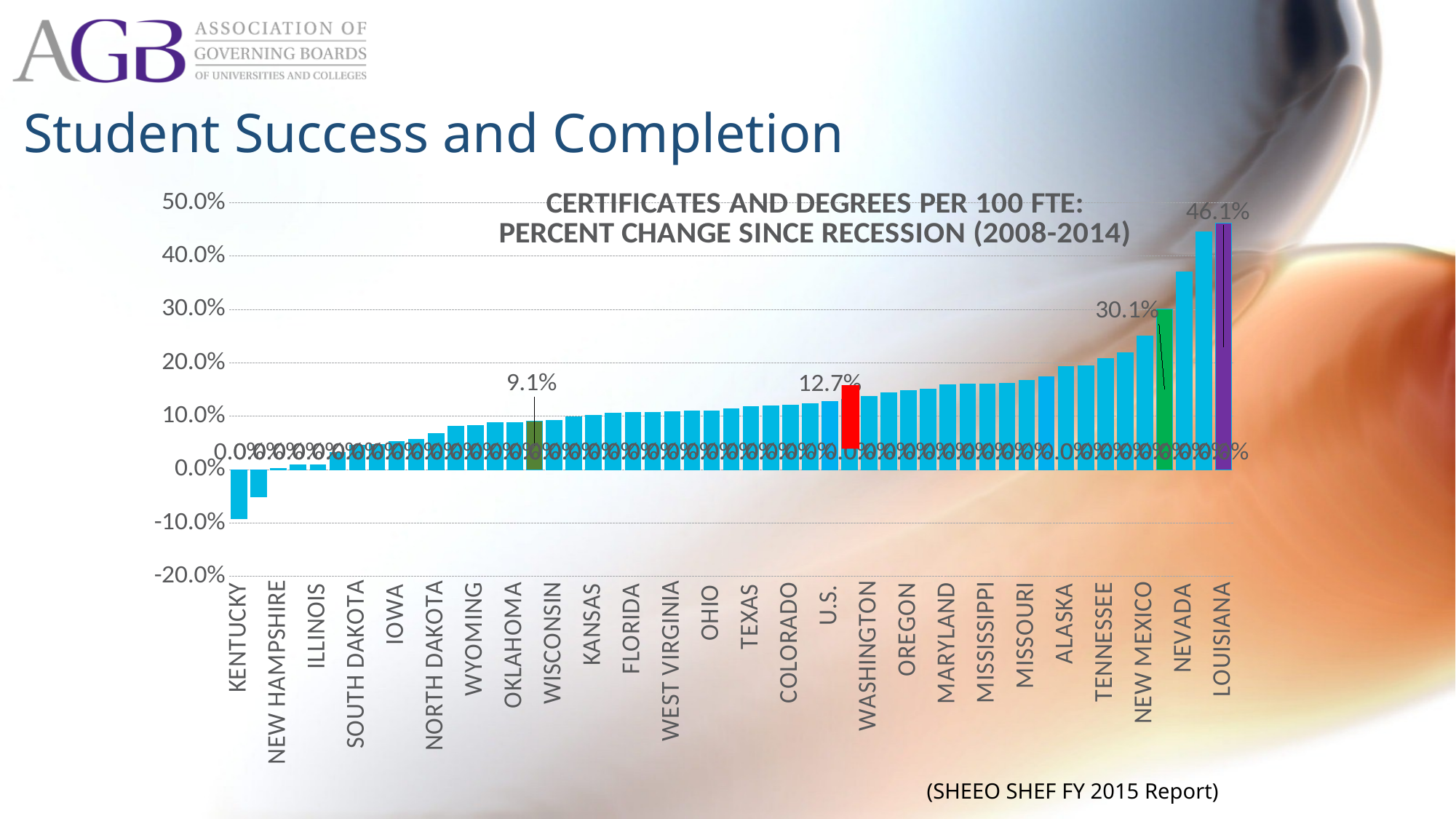
What is the value labeled on the tallest bar (Louisiana)? 46.1% Which is larger, the value for Nevada or the value for Oregon? Nevada Is the value for Kentucky greater or less than -5.0%? less Do the bar values generally rise or fall from left to right along the x axis? rise Which state has the lowest percent change in the chart? Kentucky Is the value for Nevada greater or less than 30.0%? greater Which state has the highest percent change in the chart? Louisiana Is the value for Missouri greater or less than 20.0%? less What type of chart is shown on the slide? bar chart What is the title of the chart? CERTIFICATES AND DEGREES PER 100 FTE: PERCENT CHANGE SINCE RECESSION (2008-2014) What value is labeled on the red bar? 12.7%